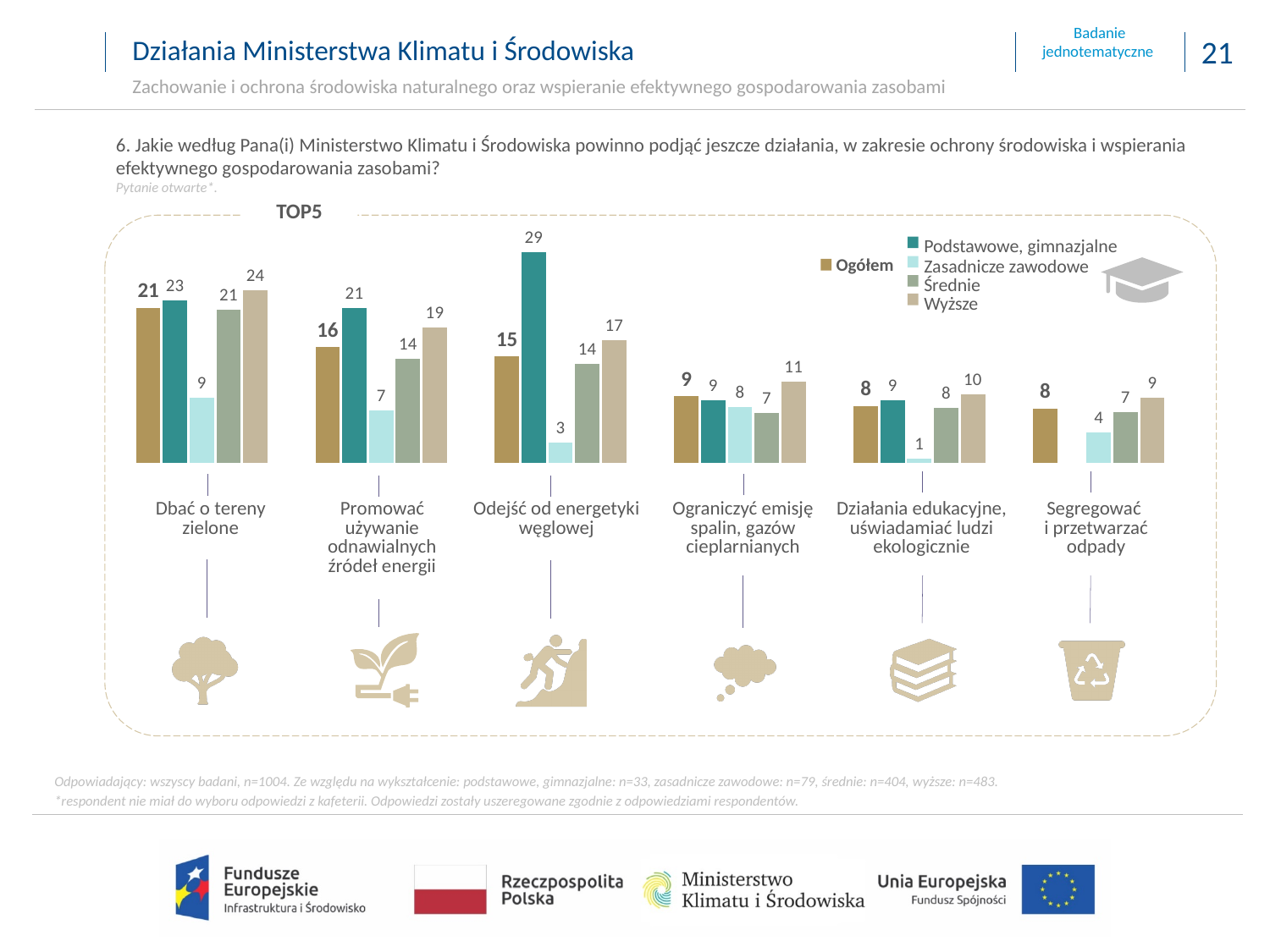
For "Dbać o tereny zielone", which is larger: the Wyższe value or the Średnie value? Wyższe Which category has the highest Ogółem value? Dbać o tereny zielone What is the value for Podstawowe, gimnazjalne for "Odejść od energetyki węglowej"? 29 What is the Ogółem value for "Dbać o tereny zielone"? 21 How many categories are shown on the x axis of the chart? 6 What is the Zasadnicze zawodowe value for "Działania edukacyjne, uświadamiać ludzi ekologicznie"? 1 What label appears above the chart in the top-left corner of the dashed box? TOP5 What kind of chart is shown on the slide? Bar chart What is the Wyższe value for "Promować używanie odnawialnych źródeł energii"? 19 Which category has the lowest Zasadnicze zawodowe value? Działania edukacyjne, uświadamiać ludzi ekologicznie How many series does the legend list? 5 What is the difference between the Podstawowe, gimnazjalne value and the Zasadnicze zawodowe value for "Odejść od energetyki węglowej"? 26